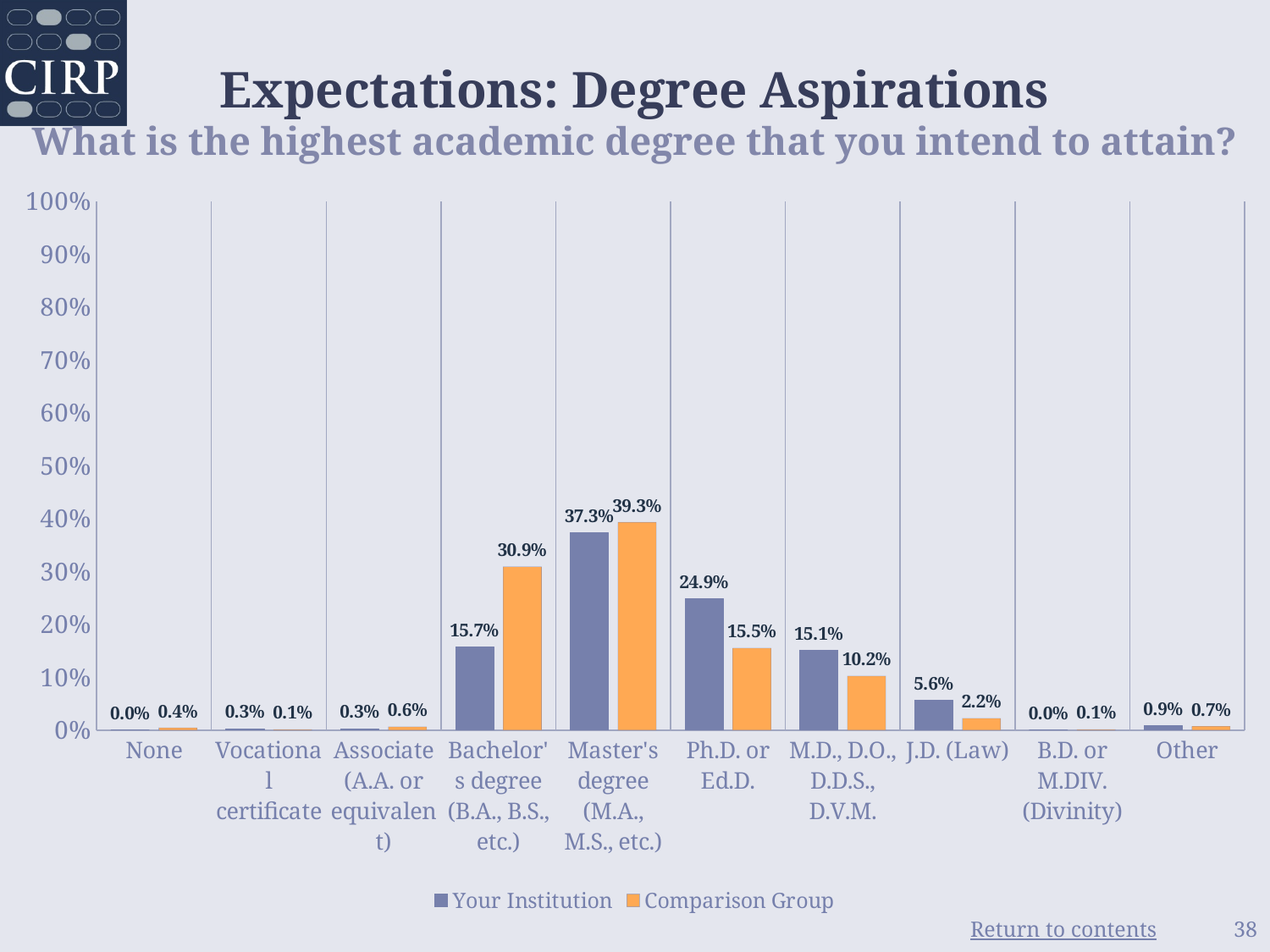
How many degree categories are shown on the x axis? 10 What is the Comparison Group value for J.D. (Law)? 2.2% Which category has the highest Comparison Group value? Master's degree (M.A., M.S., etc.) What is the Your Institution value for Ph.D. or Ed.D.? 24.9% What is the Your Institution value for Master's degree (M.A., M.S., etc.)? 37.3% For M.D., D.O., D.D.S., D.V.M., which is larger: Your Institution or Comparison Group? Your Institution What is the Comparison Group value for Bachelor's degree (B.A., B.S., etc.)? 30.9% Which category has the highest Your Institution value? Master's degree (M.A., M.S., etc.) How many series does the legend list? 2 What kind of chart is shown on the slide? Bar chart What is the difference between the Your Institution and Comparison Group values for Ph.D. or Ed.D.? 9.4% What is the difference between the Comparison Group and Your Institution values for Bachelor's degree (B.A., B.S., etc.)? 15.2%